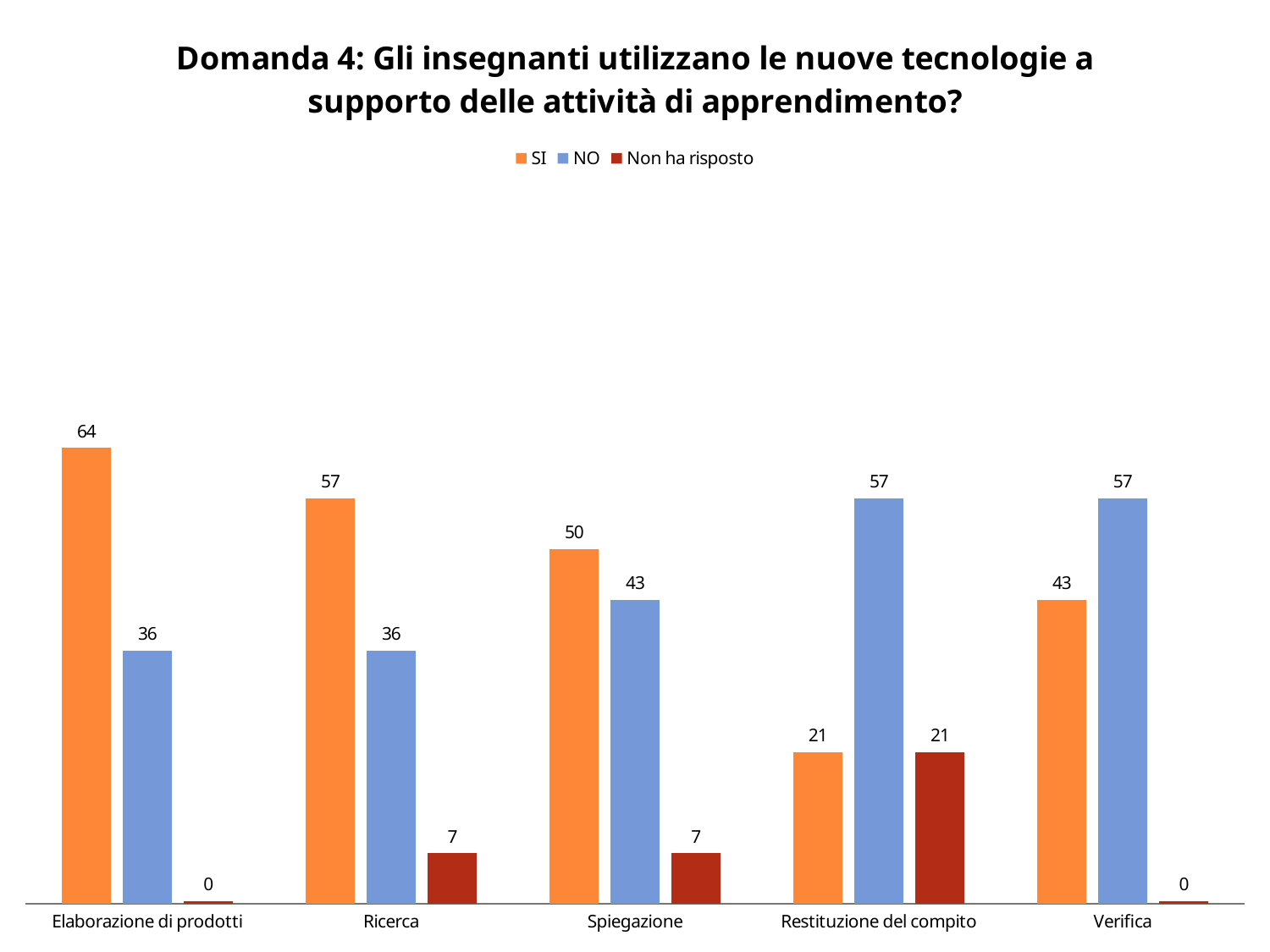
Which series is shown in dark red in the legend? Non ha risposto What kind of chart is shown on the slide? Bar chart Which category has the lowest SI value? Restituzione del compito What is the SI value for Elaborazione di prodotti? 64 What is the Non ha risposto value for Restituzione del compito? 21 What is the total of the SI, NO and Non ha risposto values for Spiegazione? 100 Which category has the highest SI value? Elaborazione di prodotti What is the NO value for Spiegazione? 43 How many categories are shown on the x axis? 5 For Verifica, which is larger, the SI value or the NO value? NO What is the difference between the SI and NO values for Ricerca? 21 How many series does the legend list? 3